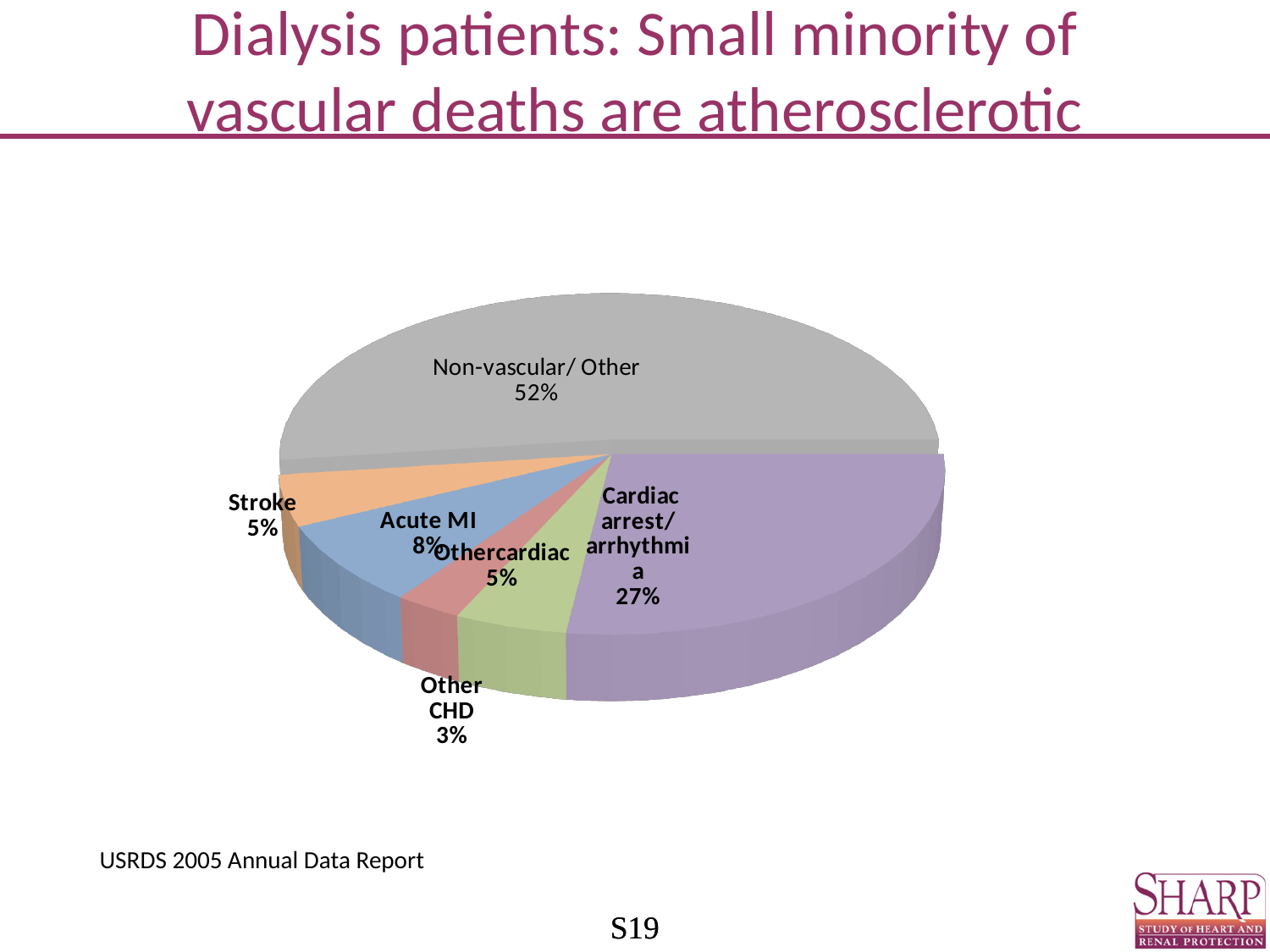
What percentage of deaths is attributed to Acute MI? 8% Which category has the smallest share of the pie? Other CHD What is the difference in percentage points between Non-vascular/ Other and Cardiac arrest/ arrhythmia? 25 How many slices does the pie chart have? 6 What kind of chart is shown on the slide? Pie chart What percentage of deaths is attributed to Stroke? 5% Which is larger, the share for Acute MI or the share for Stroke? Acute MI What source is cited below the chart? USRDS 2005 Annual Data Report Which category has the largest share of the pie? Non-vascular/ Other What percentage of deaths is attributed to Other CHD? 3% What percentage of deaths is attributed to Cardiac arrest/ arrhythmia? 27% What percentage of deaths is labelled Non-vascular/ Other? 52%